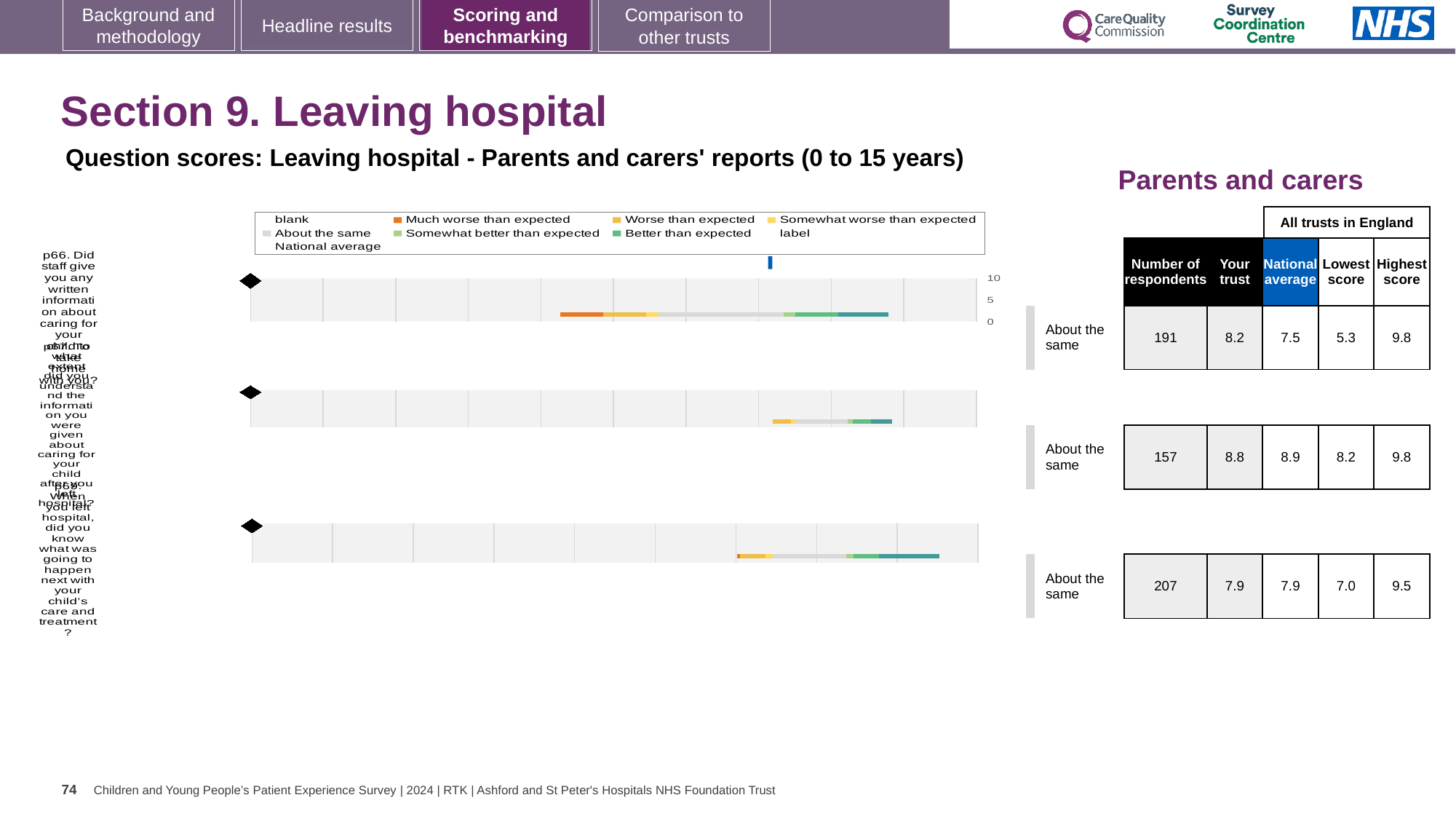
How many question charts are shown on the slide? 3 In the Parents and carers table, what is the 'Your trust' score for the question with 191 respondents? 8.2 In the Parents and carers table, what is the national average for the question with 157 respondents? 8.9 How many respondents answered the question with a 'Your trust' score of 7.9? 207 What kind of chart is used to show the question scores on this slide? bar chart In the chart legend, what colour represents 'Much worse than expected'? orange For the question with 191 respondents, is the 'Your trust' score or the national average larger? Your trust Which of the three questions has the highest 'Your trust' score in the Parents and carers table? the question with 157 respondents (8.8) What is the difference between the highest and lowest 'Your trust' scores in the Parents and carers table? 0.9 In the Parents and carers table, what is the highest score for the question with 207 respondents? 9.5 What is the title above the charts on this slide? Question scores: Leaving hospital - Parents and carers' reports (0 to 15 years) In the Parents and carers table, what is the lowest score for the question with 191 respondents? 5.3